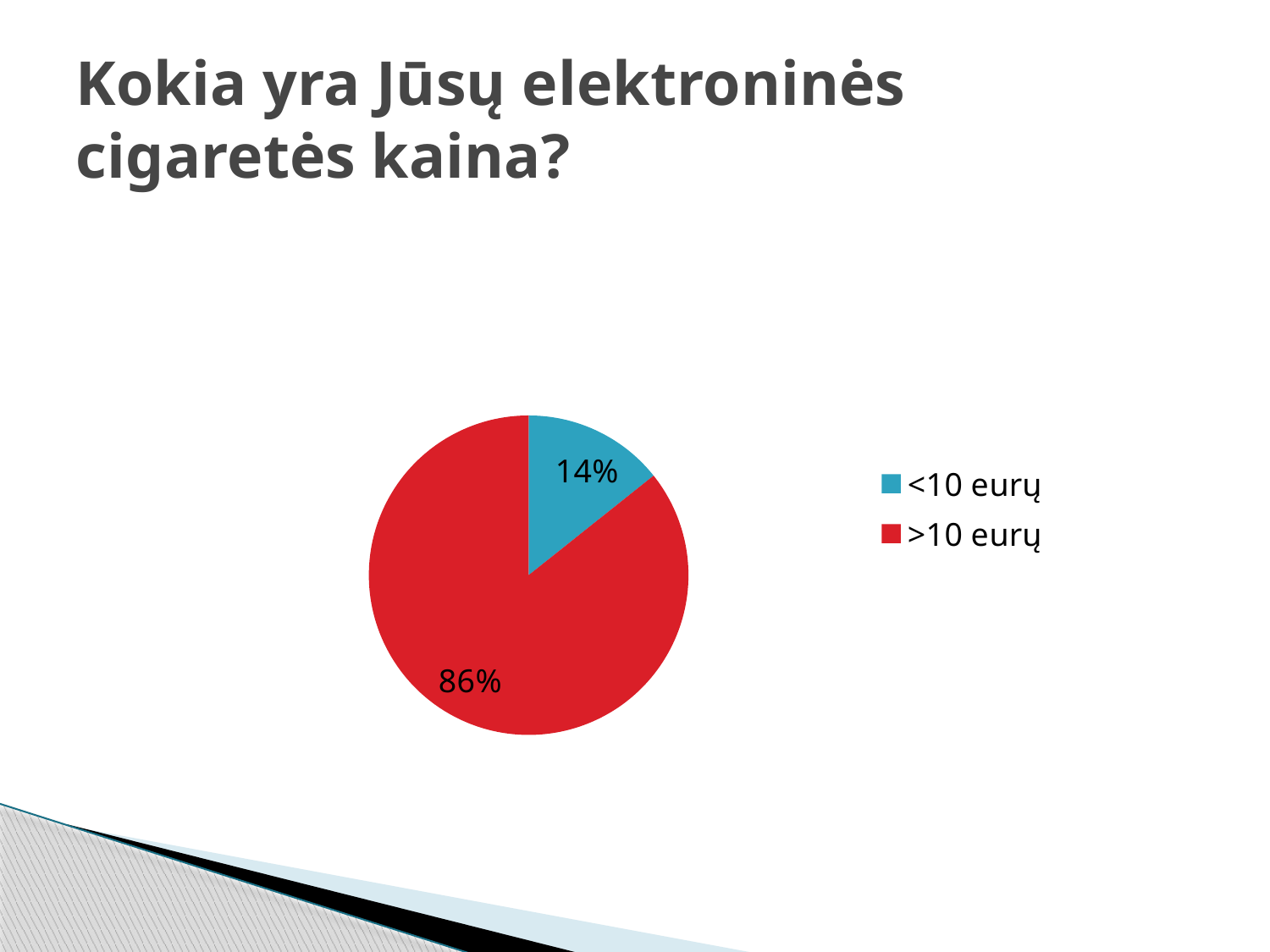
Which is larger, the "<10 eurų" slice or the ">10 eurų" slice? >10 eurų What is the difference in percentage points between the ">10 eurų" and "<10 eurų" slices? 72 What kind of chart is shown on the slide? pie chart What share of the pie does the "<10 eurų" slice represent? 14% Which category has the smallest slice of the pie? <10 eurų What colour is the "<10 eurų" slice? blue Which category has the largest slice of the pie? >10 eurų How many entries does the legend list? 2 What colour is the ">10 eurų" slice? red What share of the pie does the ">10 eurų" slice represent? 86% How many categories does the pie chart show? 2